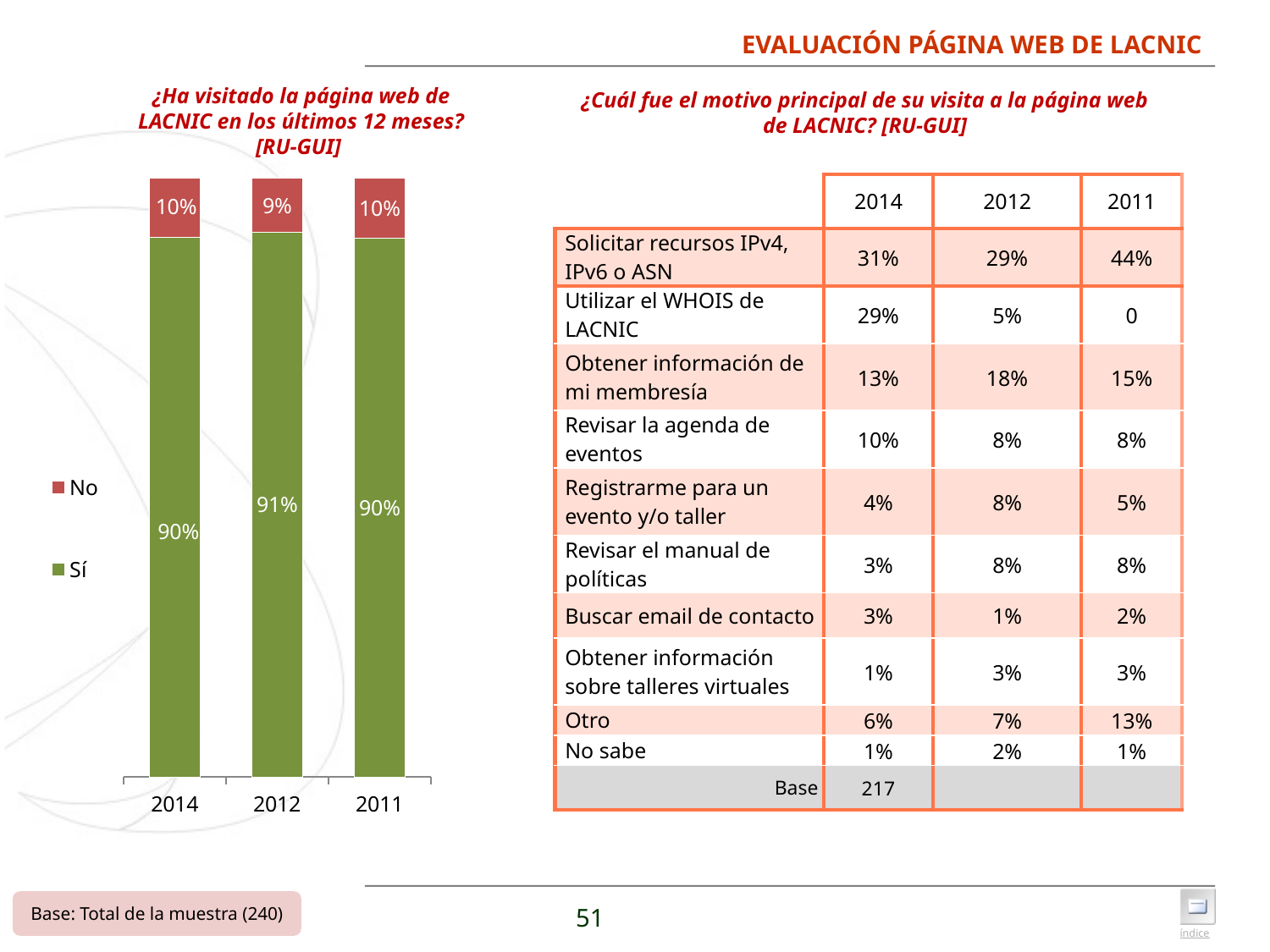
How many years (categories) are shown on the x axis of the stacked bar chart? 3 In the stacked bar chart, which year has the lowest value for "No"? 2012 In the stacked bar chart, what is the value for "Sí" in 2014? 90% What kind of chart is shown on the left of the slide? Stacked bar chart How many series does the legend of the stacked bar chart list? 2 In the stacked bar chart, which colour represents the "Sí" series? Green In the stacked bar chart, what is the difference between the "Sí" value in 2012 and the "Sí" value in 2014? 1% In the stacked bar chart, what is the total of the 2014 bar (Sí plus No)? 100% In the stacked bar chart, which year has the highest value for "Sí"? 2012 In the stacked bar chart, which is larger: the "No" value in 2014 or the "No" value in 2012? 2014 In the stacked bar chart, what is the value for "No" in 2012? 9% In the stacked bar chart, what is the value for "Sí" in 2011? 90%